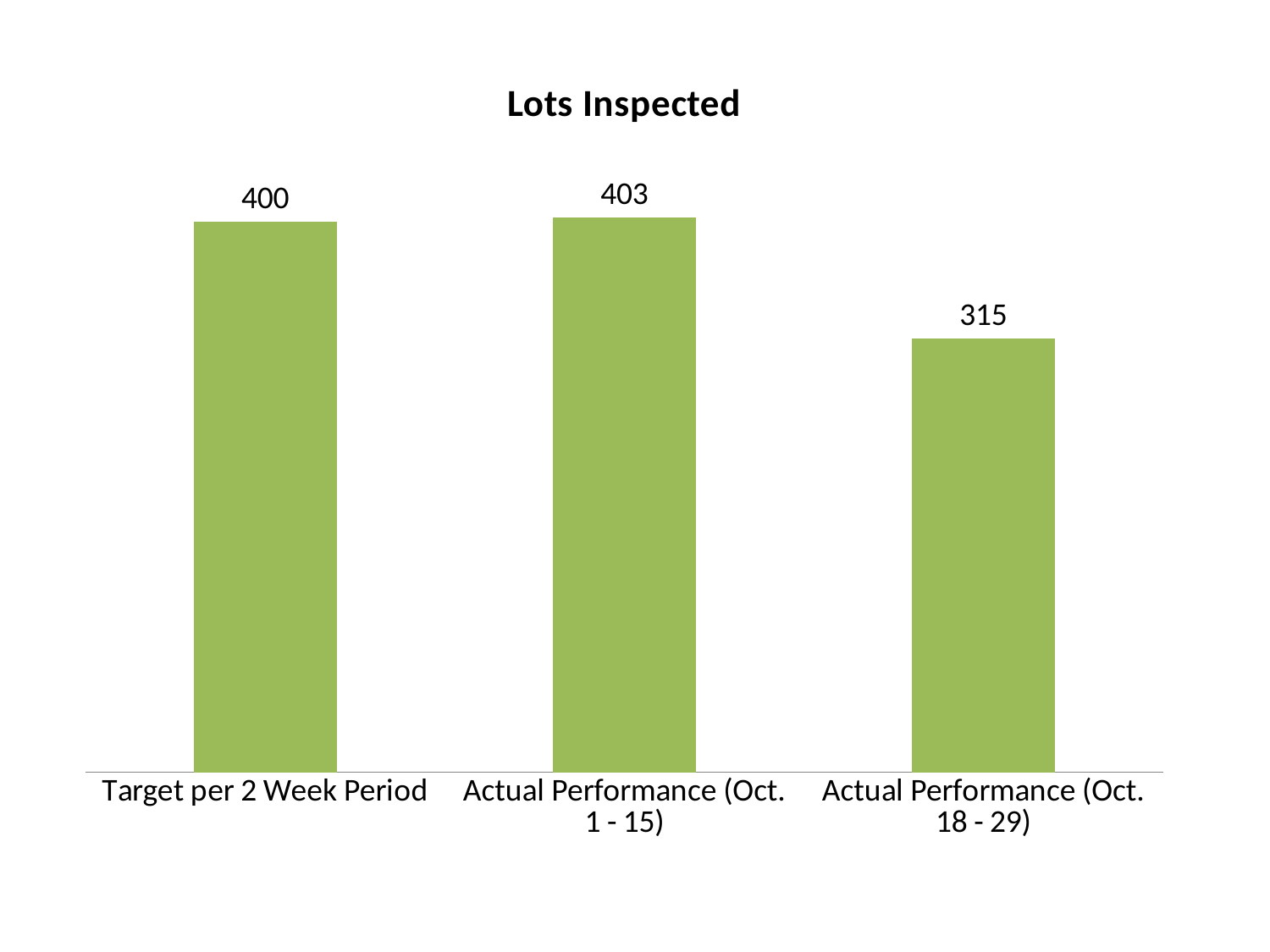
Which category has the lowest value? Actual Performance (Oct. 18 - 29) What kind of chart is shown on the slide? Bar chart What is the value for Actual Performance (Oct. 18 - 29)? 315 What is the value for Target per 2 Week Period? 400 What colour are the bars in the chart? Green Which category has the highest value? Actual Performance (Oct. 1 - 15) What is the value for Actual Performance (Oct. 1 - 15)? 403 Which is larger: Target per 2 Week Period or Actual Performance (Oct. 18 - 29)? Target per 2 Week Period What is the title of the chart? Lots Inspected What is the difference between the Target per 2 Week Period and Actual Performance (Oct. 18 - 29)? 85 What is the difference between Actual Performance (Oct. 1 - 15) and Actual Performance (Oct. 18 - 29)? 88 How many categories are shown in the chart? 3